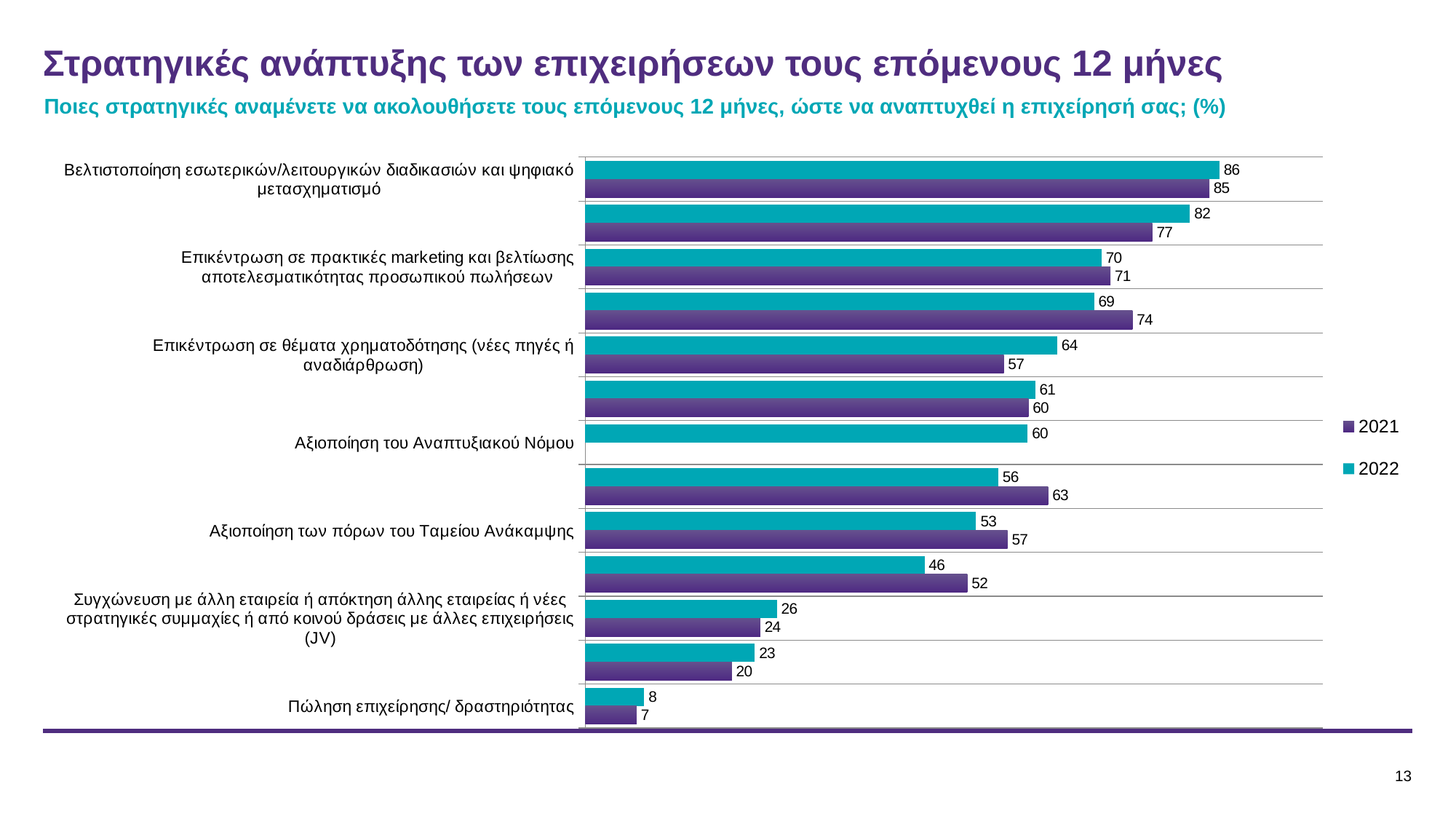
By how much does the 2022 value exceed the 2021 value for Επικέντρωση σε θέματα χρηματοδότησης (νέες πηγές ή αναδιάρθρωση)? 7 How many series does the legend list? 2 Which strategy has the lowest 2021 value? Πώληση επιχείρησης/ δραστηριότητας What is the 2021 value for Επικέντρωση σε θέματα χρηματοδότησης (νέες πηγές ή αναδιάρθρωση)? 57 What is the 2021 value for Συγχώνευση με άλλη εταιρεία ή απόκτηση άλλης εταιρείας ή νέες στρατηγικές συμμαχίες ή από κοινού δράσεις με άλλες επιχειρήσεις (JV)? 24 What is the 2022 value for Πώληση επιχείρησης/ δραστηριότητας? 8 Which strategy has the highest 2022 value? Βελτιστοποίηση εσωτερικών/λειτουργικών διαδικασιών και ψηφιακό μετασχηματισμό What is the 2022 value for Βελτιστοποίηση εσωτερικών/λειτουργικών διαδικασιών και ψηφιακό μετασχηματισμό? 86 What is the 2021 value for Βελτιστοποίηση εσωτερικών/λειτουργικών διαδικασιών και ψηφιακό μετασχηματισμό? 85 What kind of chart is shown on the slide? Bar chart What is the 2022 value for Αξιοποίηση του Αναπτυξιακού Νόμου? 60 For Αξιοποίηση των πόρων του Ταμείου Ανάκαμψης, which year has the larger value, 2021 or 2022? 2021